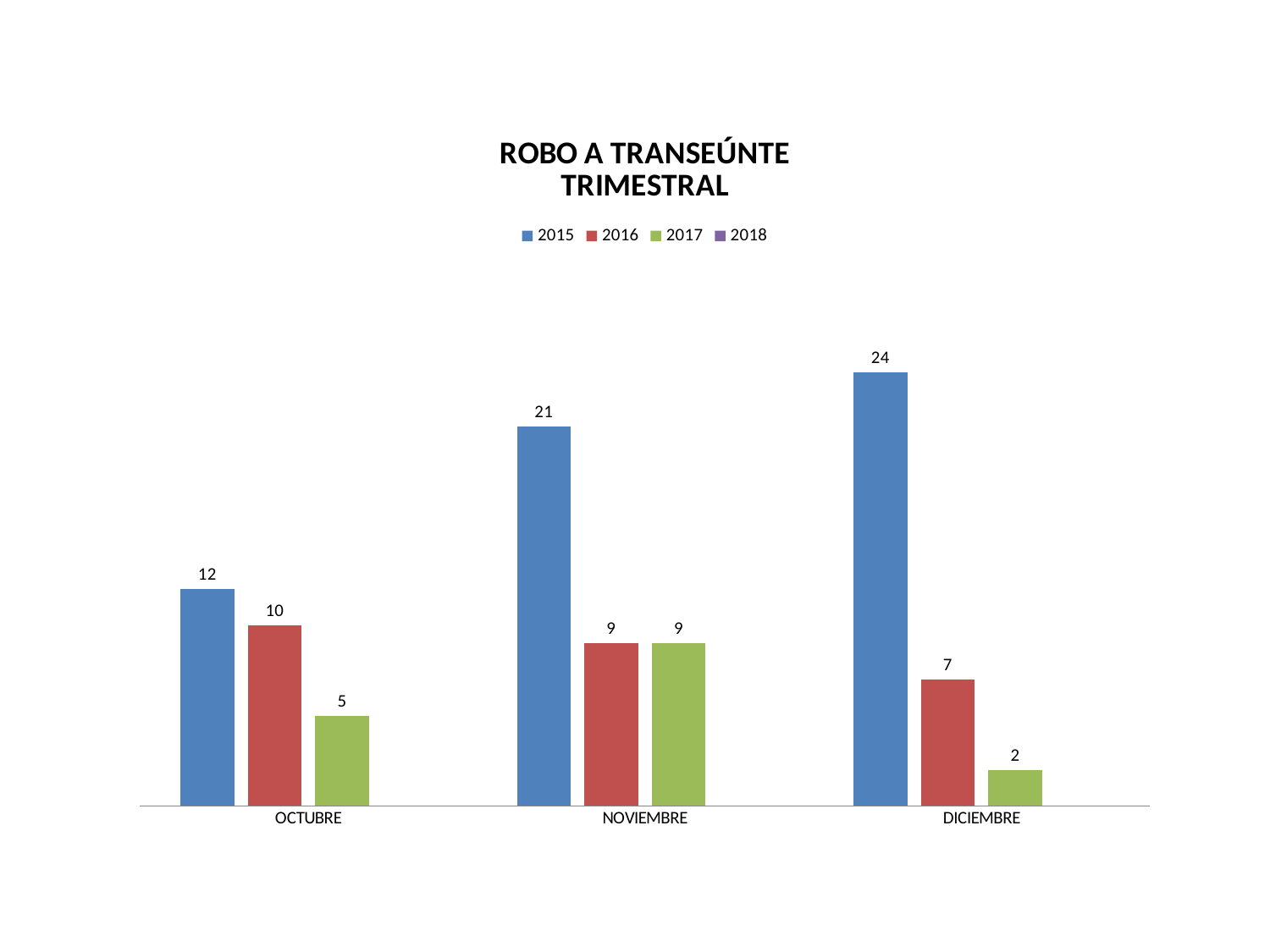
How many months are shown on the x axis? 3 What is the value for 2017 in DICIEMBRE? 2 In which month is the 2015 value highest? DICIEMBRE Does the 2017 series rise or fall from NOVIEMBRE to DICIEMBRE? fall What is the value for 2016 in NOVIEMBRE? 9 Which is larger, the 2016 value in OCTUBRE or the 2016 value in DICIEMBRE? OCTUBRE What is the difference between the 2015 and 2016 values in DICIEMBRE? 17 What is the value for 2015 in OCTUBRE? 12 What kind of chart is this? bar chart In which month is the 2017 value lowest? DICIEMBRE How many series does the legend list? 4 What is the difference between the 2015 values for NOVIEMBRE and OCTUBRE? 9